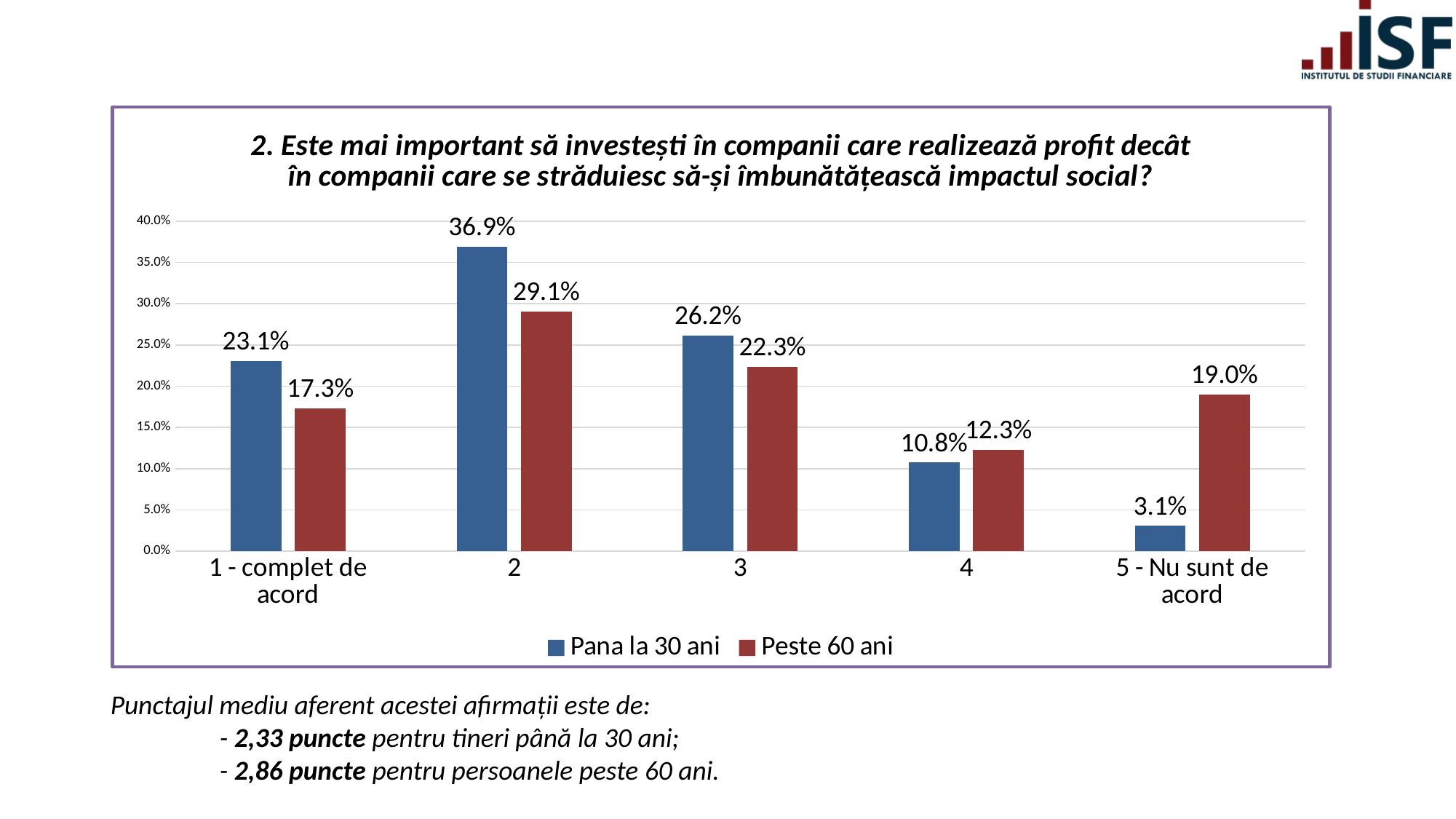
Which colour represents the 'Peste 60 ani' series? red How many series does the legend list? 2 Is the value for 'Peste 60 ani' in category 3 greater or less than 20.0%? greater Which category has the lowest value for the 'Pana la 30 ani' series? 5 - Nu sunt de acord How many categories are shown on the x axis? 5 What is the value for 'Pana la 30 ani' in category '1 - complet de acord'? 23.1% What is the difference between 'Pana la 30 ani' and 'Peste 60 ani' in category 2? 7.8% What kind of chart is shown on the slide? bar chart Which category has the highest value for the 'Peste 60 ani' series? 2 In category 4, which series has the larger value, 'Pana la 30 ani' or 'Peste 60 ani'? Peste 60 ani What is the value for 'Pana la 30 ani' in category 2? 36.9% What is the value for 'Peste 60 ani' in category '5 - Nu sunt de acord'? 19.0%